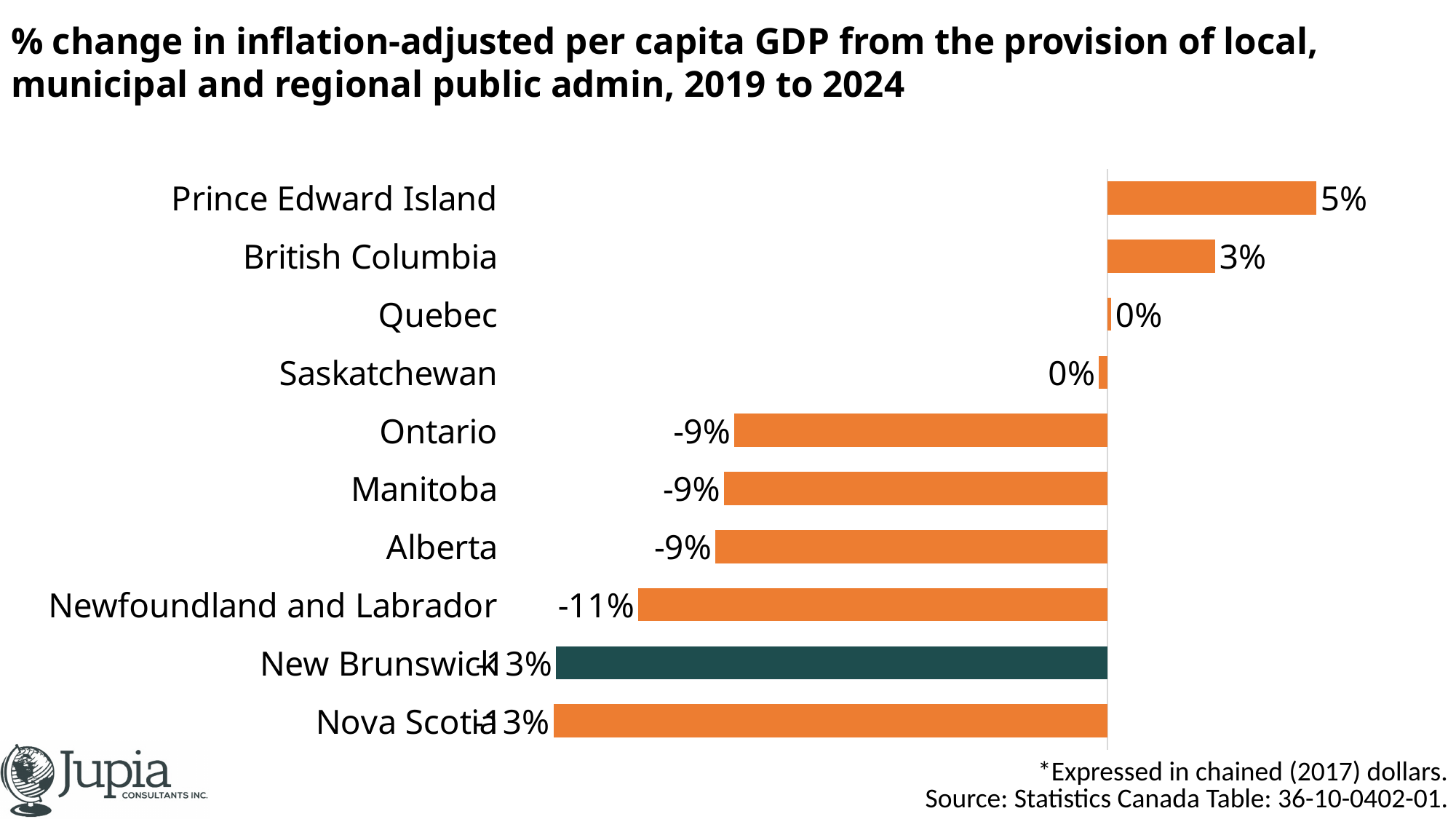
What is the value for Prince Edward Island? 5% What is the value for Newfoundland and Labrador? -11% What is the value for British Columbia? 3% What kind of chart is shown on the slide? Bar chart Which is larger, the value for Ontario or the value for Newfoundland and Labrador? Ontario What is the value for Quebec? 0% What is the value for Ontario? -9% How many provinces are shown in the chart? 10 Which province's bar is shown in a different colour from the others? New Brunswick What is the difference between the values for Prince Edward Island and Newfoundland and Labrador? 16 percentage points Which province has the highest value? Prince Edward Island What is the difference between the values for Prince Edward Island and British Columbia? 2 percentage points